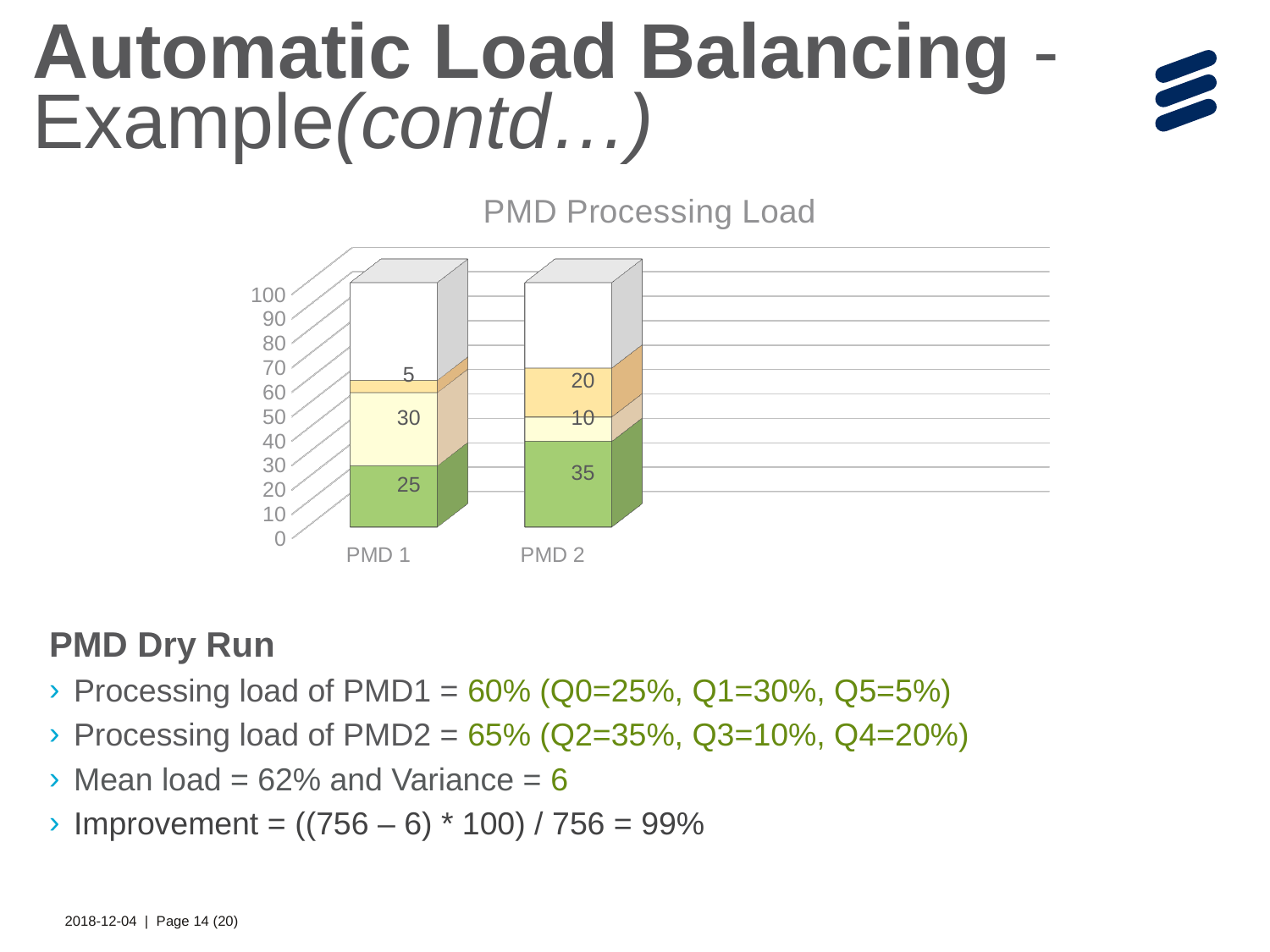
What is the value of the middle labelled segment of the PMD 2 bar? 10 What is the sum of the three labelled segments of the PMD 2 bar? 65 What is the title of the chart? PMD Processing Load What is the value of the top labelled segment of the PMD 2 bar? 20 How many categories are shown on the x axis of the chart? 2 What is the difference between the bottom (green) segment values of PMD 2 and PMD 1? 10 What is the sum of the three labelled segments of the PMD 1 bar? 60 What is the value of the smallest labelled segment of the PMD 1 bar? 5 What kind of chart is shown on the slide? Stacked bar chart Which bar has the larger bottom (green) segment, PMD 1 or PMD 2? PMD 2 What is the value of the bottom (green) segment of the PMD 1 bar? 25 What is the value of the bottom (green) segment of the PMD 2 bar? 35